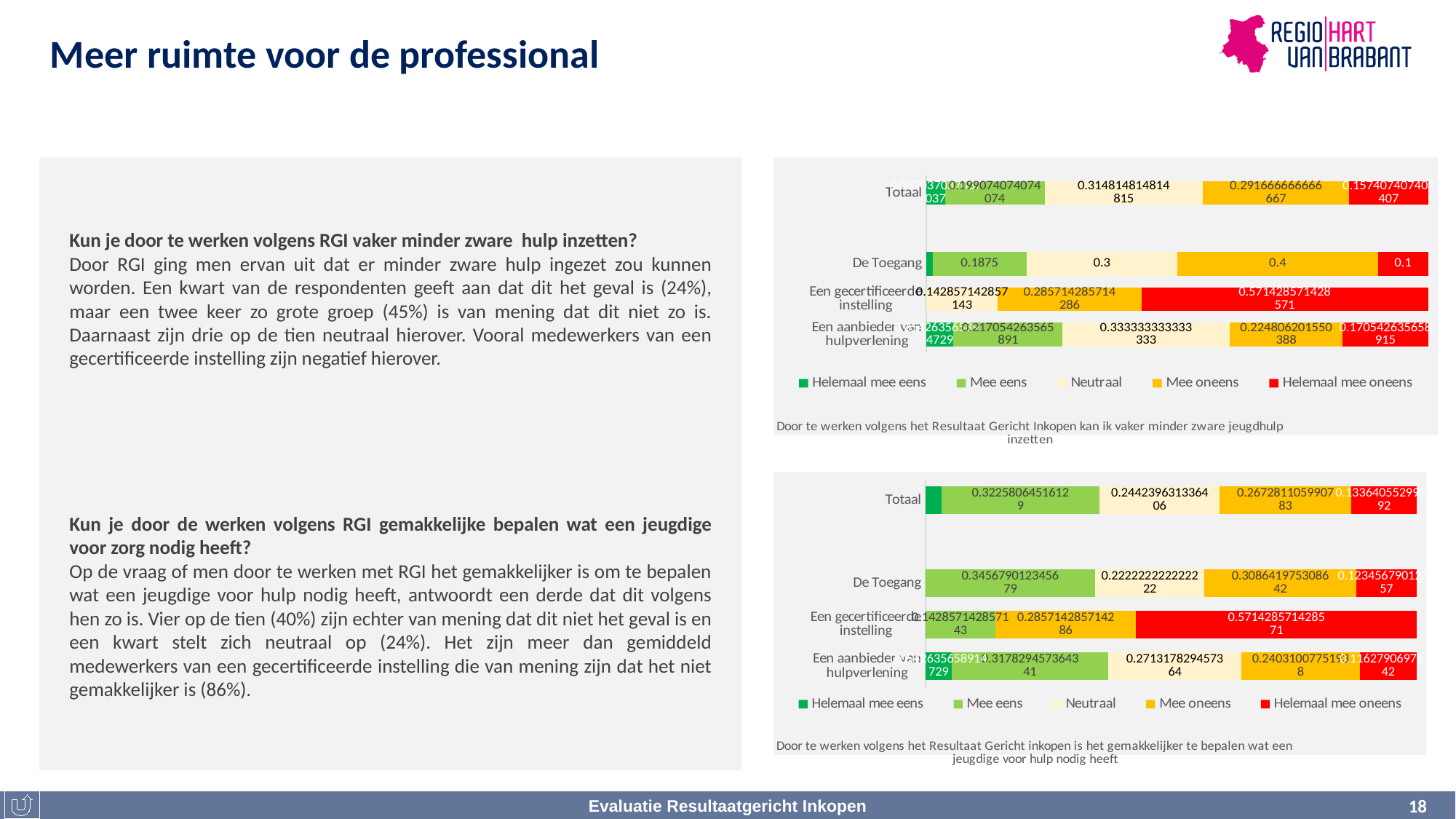
In the top chart ("...kan ik vaker minder zware jeugdhulp inzetten"), what is the value for Neutraal for De Toegang? 0.3 What kind of chart is the bottom chart? Stacked bar chart In the top chart ("...kan ik vaker minder zware jeugdhulp inzetten"), what is the value for Mee eens for De Toegang? 0.1875 In the top chart ("...kan ik vaker minder zware jeugdhulp inzetten"), what is the value for Mee oneens for De Toegang? 0.4 In the top chart ("...kan ik vaker minder zware jeugdhulp inzetten"), what is the value for Helemaal mee oneens for De Toegang? 0.1 How many categories are shown on the y axis of the bottom chart? 4 How many series does the legend of the top chart list? 5 In the top chart ("...kan ik vaker minder zware jeugdhulp inzetten"), what is the difference between Mee oneens and Helemaal mee oneens for De Toegang? 0.3 In the bottom chart ("...gemakkelijker te bepalen wat een jeugdige voor hulp nodig heeft"), which is larger for De Toegang: Mee eens or Neutraal? Mee eens In the top chart ("...kan ik vaker minder zware jeugdhulp inzetten"), which category has the highest Helemaal mee oneens value? Een gecertificeerde instelling In the top chart ("...kan ik vaker minder zware jeugdhulp inzetten"), what is the value for Helemaal mee oneens for Een gecertificeerde instelling? 0.571428571428571